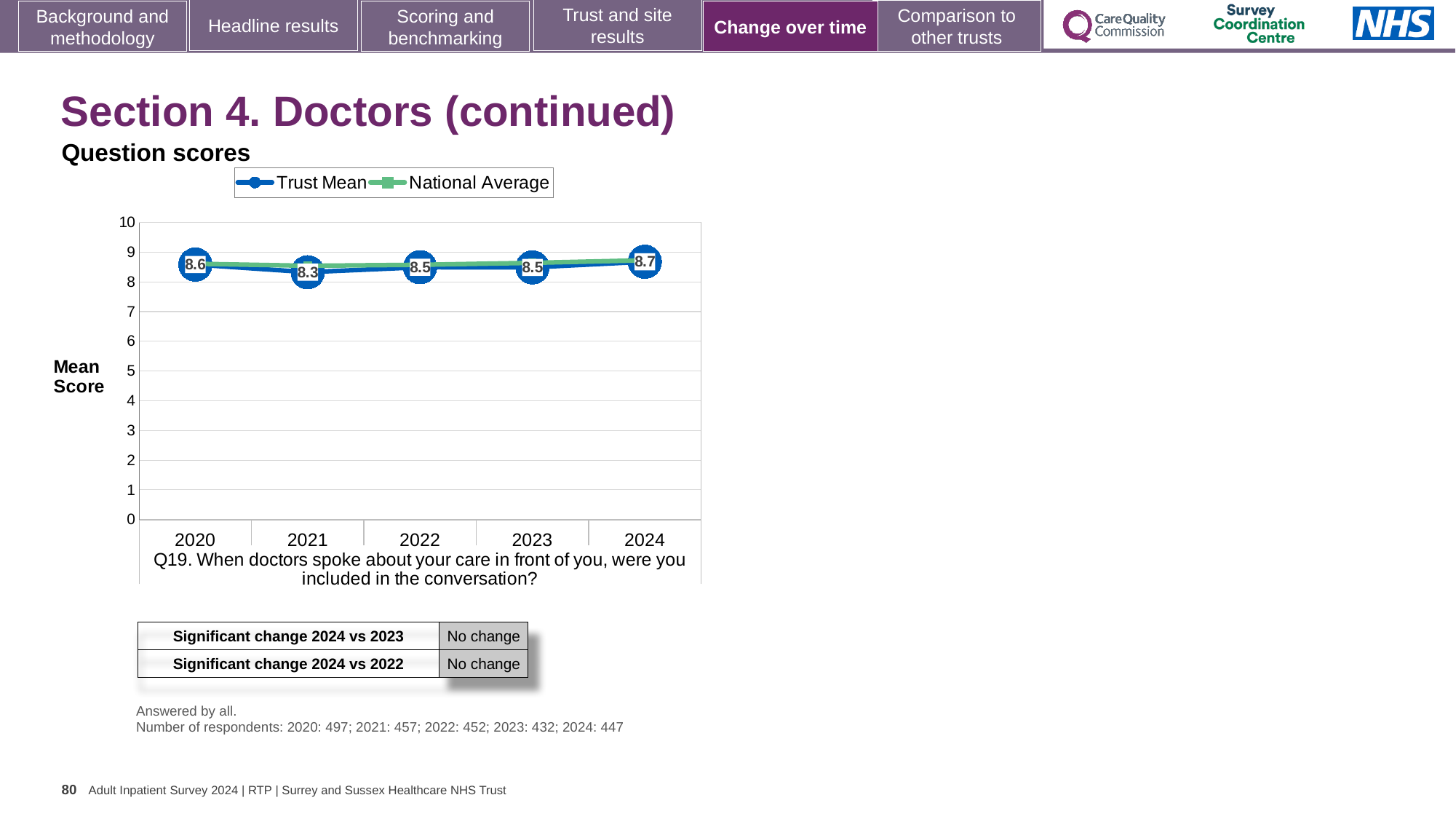
What is the Trust Mean score for 2024? 8.7 How many years are plotted on the x axis? 5 Does the Trust Mean score rise or fall from 2021 to 2024? Rise What kind of chart is shown on the slide? Line chart What is the difference between the Trust Mean score in 2024 and in 2021? 0.4 What is the Trust Mean score for 2020? 8.6 How many series does the legend list? 2 In which year is the Trust Mean score highest? 2024 Which year has the larger Trust Mean score, 2020 or 2021? 2020 Is the National Average value for 2022 greater or less than 8? greater In which year is the Trust Mean score lowest? 2021 What is the Trust Mean score for 2021? 8.3